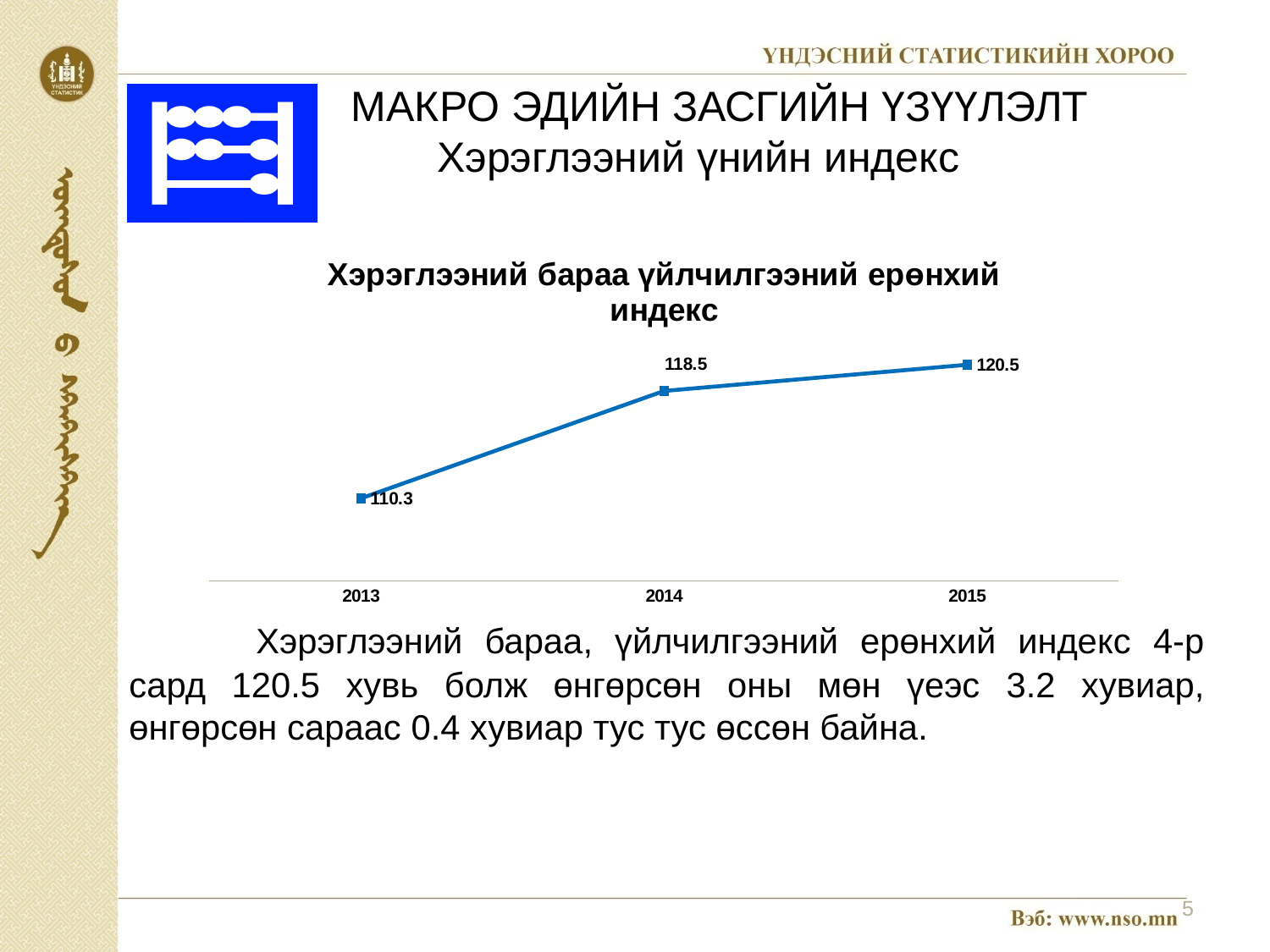
What kind of chart is shown on the slide? line chart What is the difference between the values for 2015 and 2013? 10.2 How many years are plotted on the chart? 3 Which year has the highest value? 2015 What is the difference between the values for 2014 and 2013? 8.2 Do the values rise or fall from 2013 to 2015? rise What is the title of the chart? Хэрэглээний бараа үйлчилгээний ерөнхий индекс What is the value for 2013? 110.3 Which is larger, the value for 2014 or the value for 2015? 2015 What is the value for 2015? 120.5 What is the value for 2014? 118.5 Which year has the lowest value? 2013